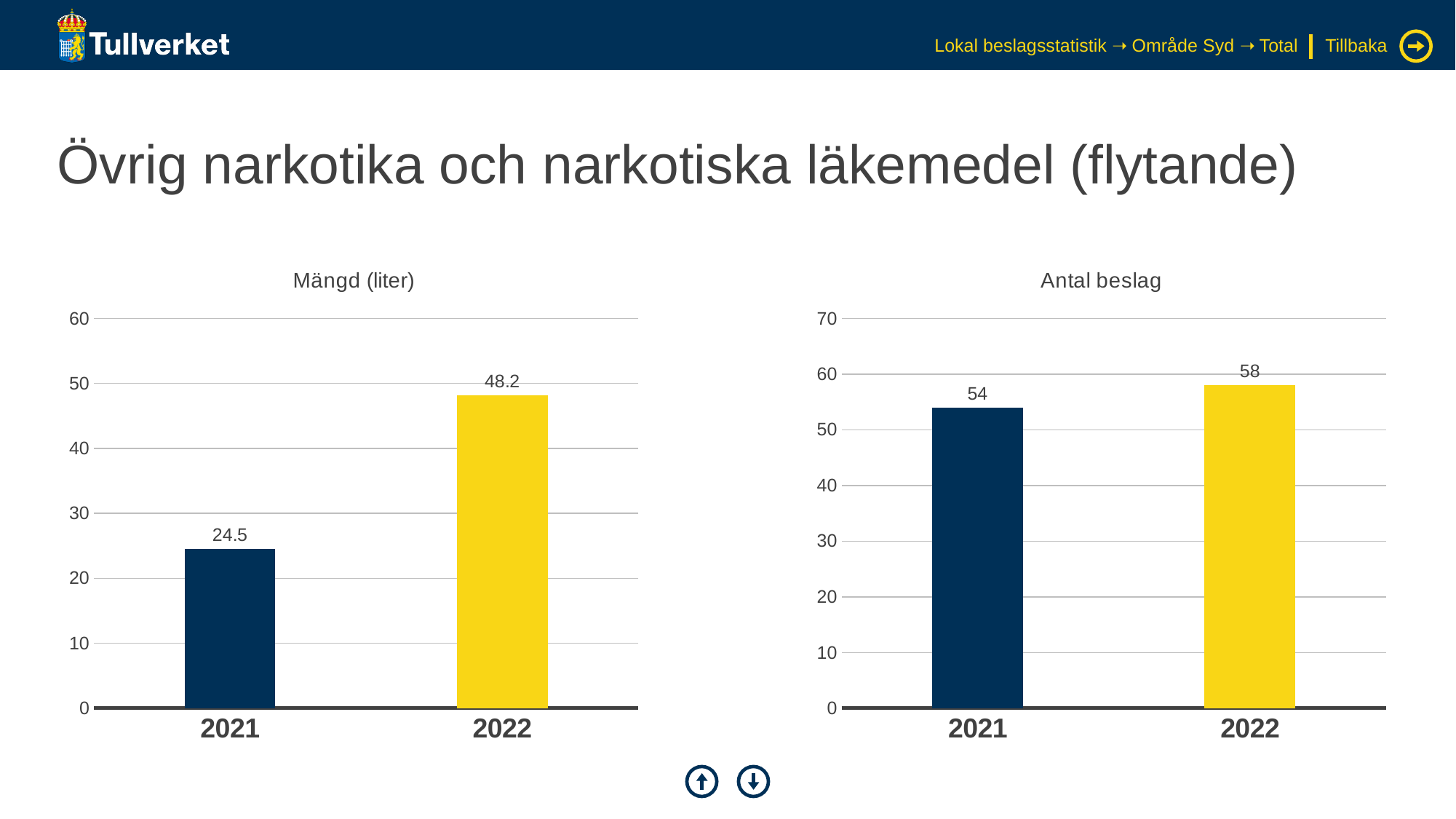
What kind of chart is the 'Antal beslag' chart? bar chart In the 'Antal beslag' chart, which year has the lowest value? 2021 In the 'Antal beslag' chart, what is the value for 2022? 58 In the 'Mängd (liter)' chart, what is the difference between the 2022 and 2021 values? 23.7 In the 'Antal beslag' chart, what is the value for 2021? 54 In the 'Antal beslag' chart, what is the difference between the 2022 and 2021 values? 4 In the 'Antal beslag' chart, is the value for 2021 greater or less than 50? greater In the 'Mängd (liter)' chart, do the values rise or fall from 2021 to 2022? rise How many years are shown in the 'Mängd (liter)' chart? 2 In the 'Mängd (liter)' chart, what is the value for 2021? 24.5 In the 'Mängd (liter)' chart, which year has the highest value? 2022 In the 'Mängd (liter)' chart, what is the value for 2022? 48.2